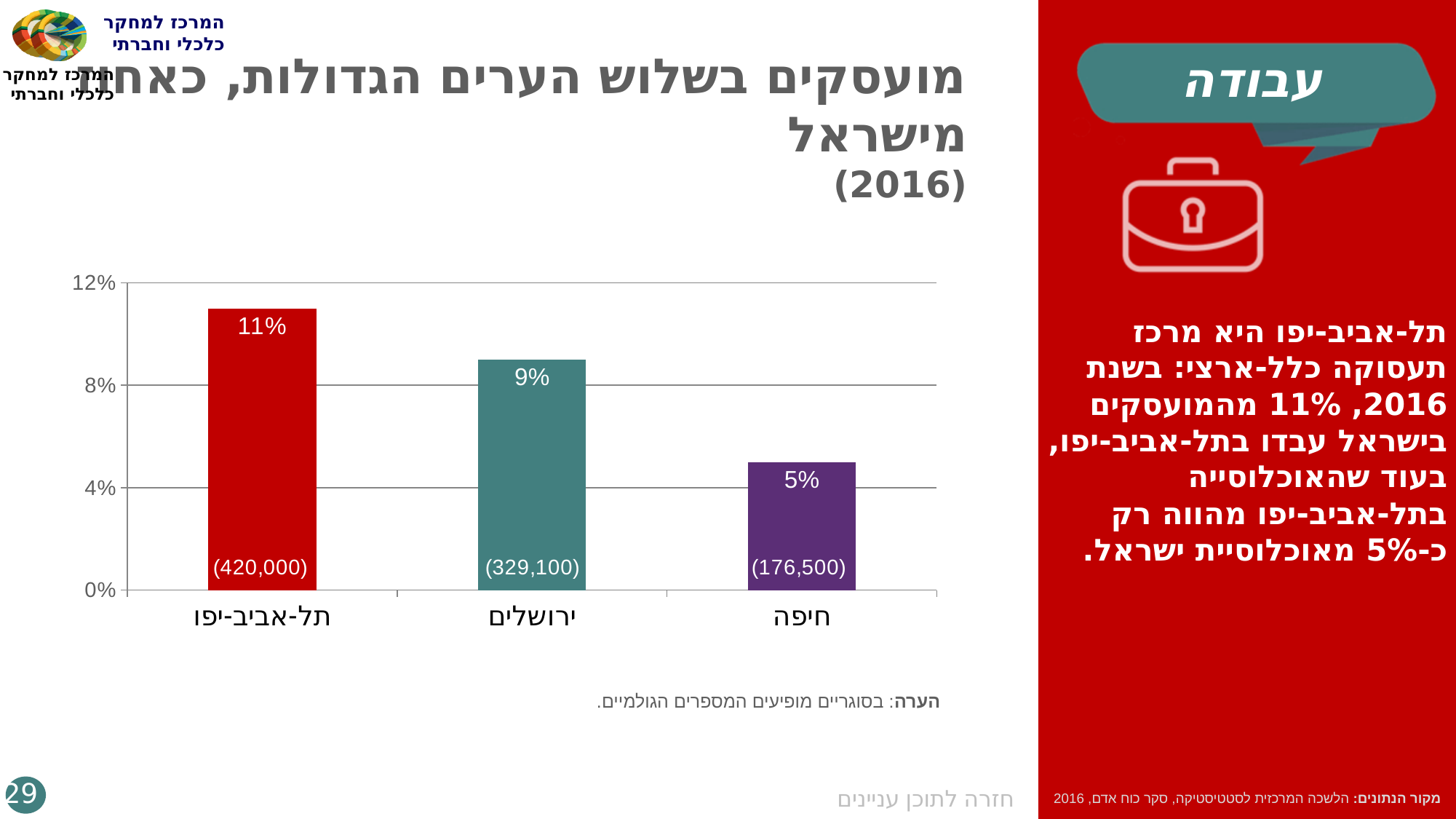
Which city has the highest value? תל-אביב-יפו What is the value for חיפה? 5% What is the value for ירושלים? 9% What is the difference between the values for תל-אביב-יפו and חיפה? 6% What absolute number is shown in parentheses on the bar for חיפה? (176,500) What is the value for תל-אביב-יפו? 11% How many cities are shown in the chart? 3 Which city has the lowest value? חיפה Which is larger, the value for ירושלים or the value for חיפה? ירושלים What year is given in the chart title? 2016 What kind of chart is shown on the slide? bar chart What absolute number is shown in parentheses on the bar for ירושלים? (329,100)